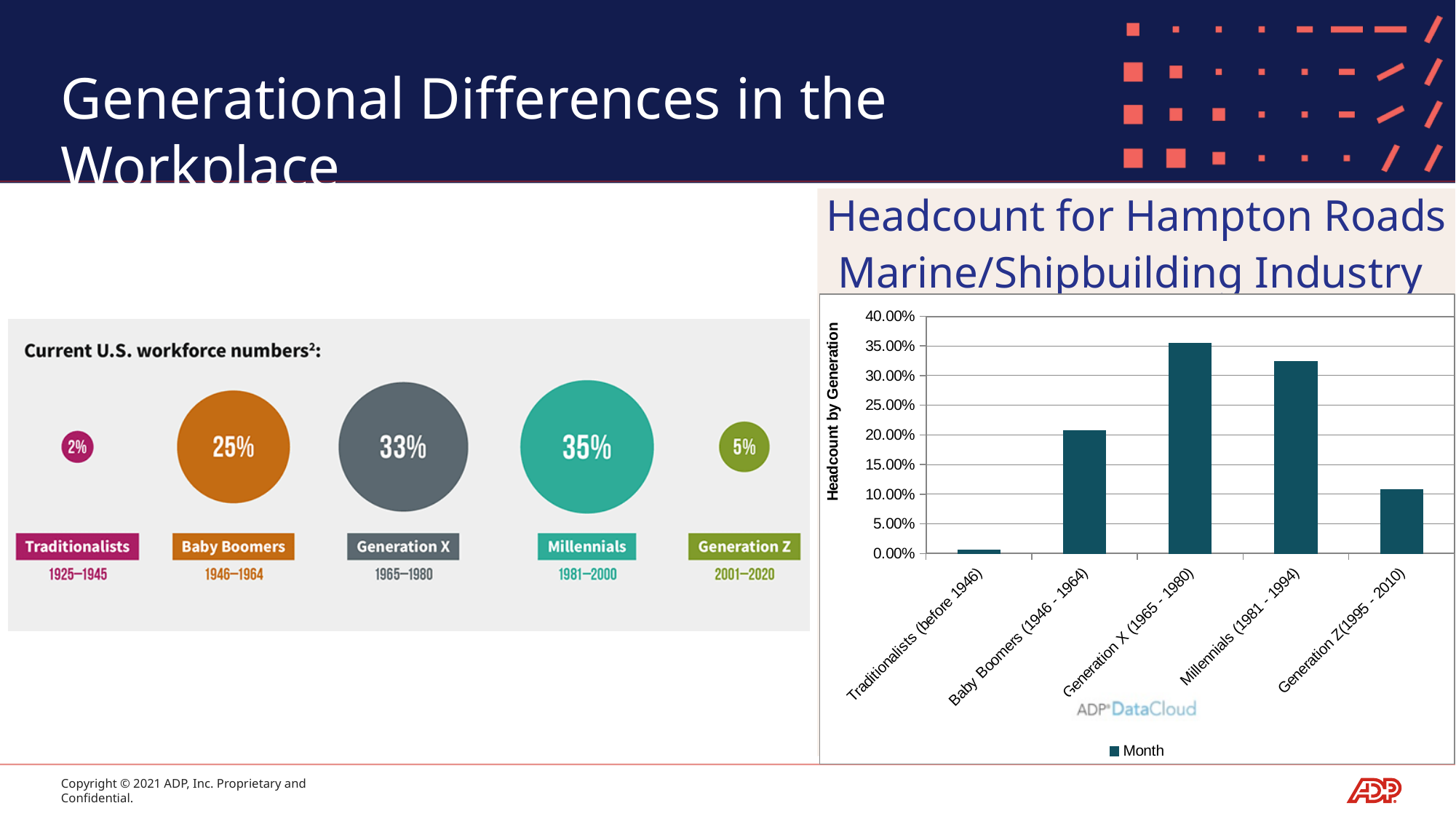
On the right-hand 'Headcount for Hampton Roads Marine/Shipbuilding Industry' chart, is the value for Millennials (1981 - 1994) greater or less than 30.00%? greater On the right-hand 'Headcount for Hampton Roads Marine/Shipbuilding Industry' chart, is the value for Generation Z (1995 - 2010) greater or less than 15.00%? less On the right-hand 'Headcount for Hampton Roads Marine/Shipbuilding Industry' chart, what is the label on the vertical axis? Headcount by Generation On the right-hand chart titled 'Headcount for Hampton Roads Marine/Shipbuilding Industry', what kind of chart is shown? bar chart On the right-hand 'Headcount for Hampton Roads Marine/Shipbuilding Industry' chart, how many series does the legend list? 1 On the right-hand 'Headcount for Hampton Roads Marine/Shipbuilding Industry' chart, which generation has the highest headcount share? Generation X (1965 - 1980) On the left-hand 'Current U.S. workforce numbers' graphic, what percentage is shown for Millennials? 35% On the right-hand 'Headcount for Hampton Roads Marine/Shipbuilding Industry' chart, which is larger: the value for Baby Boomers (1946 - 1964) or Generation Z (1995 - 2010)? Baby Boomers (1946 - 1964) On the right-hand 'Headcount for Hampton Roads Marine/Shipbuilding Industry' chart, how many generation categories are plotted? 5 On the right-hand 'Headcount for Hampton Roads Marine/Shipbuilding Industry' chart, is the value for Baby Boomers (1946 - 1964) greater or less than 25.00%? less On the right-hand 'Headcount for Hampton Roads Marine/Shipbuilding Industry' chart, which generation has the lowest headcount share? Traditionalists (before 1946) On the left-hand 'Current U.S. workforce numbers' graphic, what is the difference between the Generation X and Baby Boomers percentages? 8%